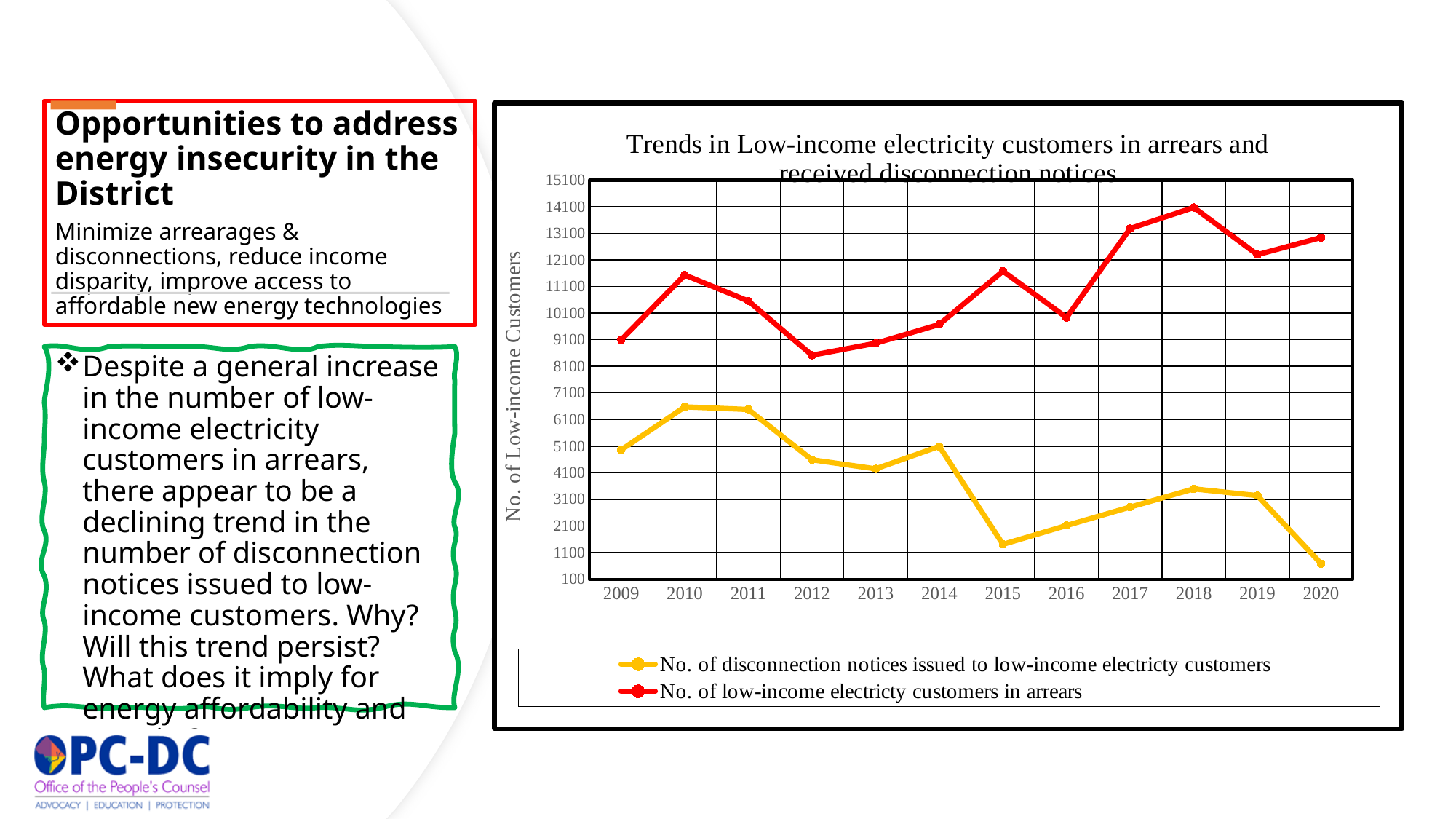
Which year has more low-income electricity customers in arrears, 2015 or 2016? 2015 In which year is the number of low-income electricity customers in arrears lowest? 2012 What colour is the line for the number of low-income electricity customers in arrears? Red In which year is the number of disconnection notices issued to low-income electricity customers lowest? 2020 Is the number of disconnection notices issued to low-income electricity customers in 2015 greater or less than 2100? less Is the number of disconnection notices issued to low-income electricity customers in 2010 greater or less than 6100? greater Is the number of low-income electricity customers in arrears in 2017 greater or less than 13100? greater How many years are shown on the x axis? 12 In which year is the number of low-income electricity customers in arrears highest? 2018 Overall, does the number of disconnection notices issued to low-income electricity customers rise or fall from 2009 to 2020? Fall What kind of chart is shown on the slide? Line chart How many series does the legend list? 2